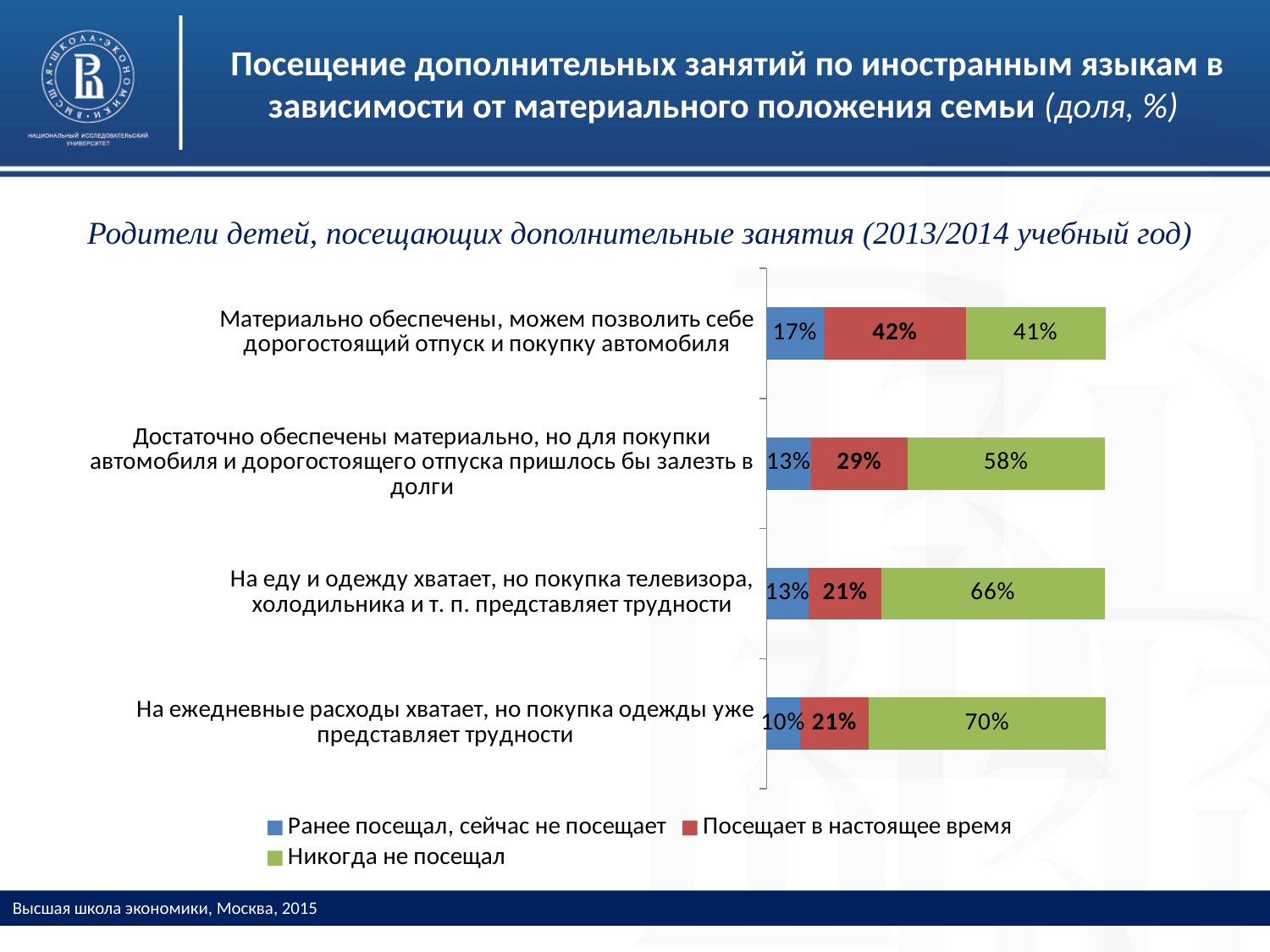
Which colour represents "Никогда не посещал" in the legend? Green What is the difference between the "Никогда не посещал" shares of the group "На еду и одежду хватает, но покупка телевизора, холодильника и т. п. представляет трудности" and the group "Материально обеспечены, можем позволить себе дорогостоящий отпуск и покупку автомобиля"? 25% How many series does the legend list? 3 What is the value of "Ранее посещал, сейчас не посещает" for the group "Достаточно обеспечены материально, но для покупки автомобиля и дорогостоящего отпуска пришлось бы залезть в долги"? 13% Which group has the highest share of "Посещает в настоящее время"? Материально обеспечены, можем позволить себе дорогостоящий отпуск и покупку автомобиля What share of parents in the group "Материально обеспечены, можем позволить себе дорогостоящий отпуск и покупку автомобиля" falls under "Посещает в настоящее время"? 42% What is the total of the stacked bar for the group "Материально обеспечены, можем позволить себе дорогостоящий отпуск и покупку автомобиля"? 100% What type of chart is shown on the slide? Stacked bar chart What is the value of "Никогда не посещал" for the group "На ежедневные расходы хватает, но покупка одежды уже представляет трудности"? 70% How many family income groups are shown on the chart? 4 Which is larger: the "Посещает в настоящее время" share for "Достаточно обеспечены материально..." or for "На еду и одежду хватает..."? Достаточно обеспечены материально, но для покупки автомобиля и дорогостоящего отпуска пришлось бы залезть в долги Which group has the lowest share of "Никогда не посещал"? Материально обеспечены, можем позволить себе дорогостоящий отпуск и покупку автомобиля